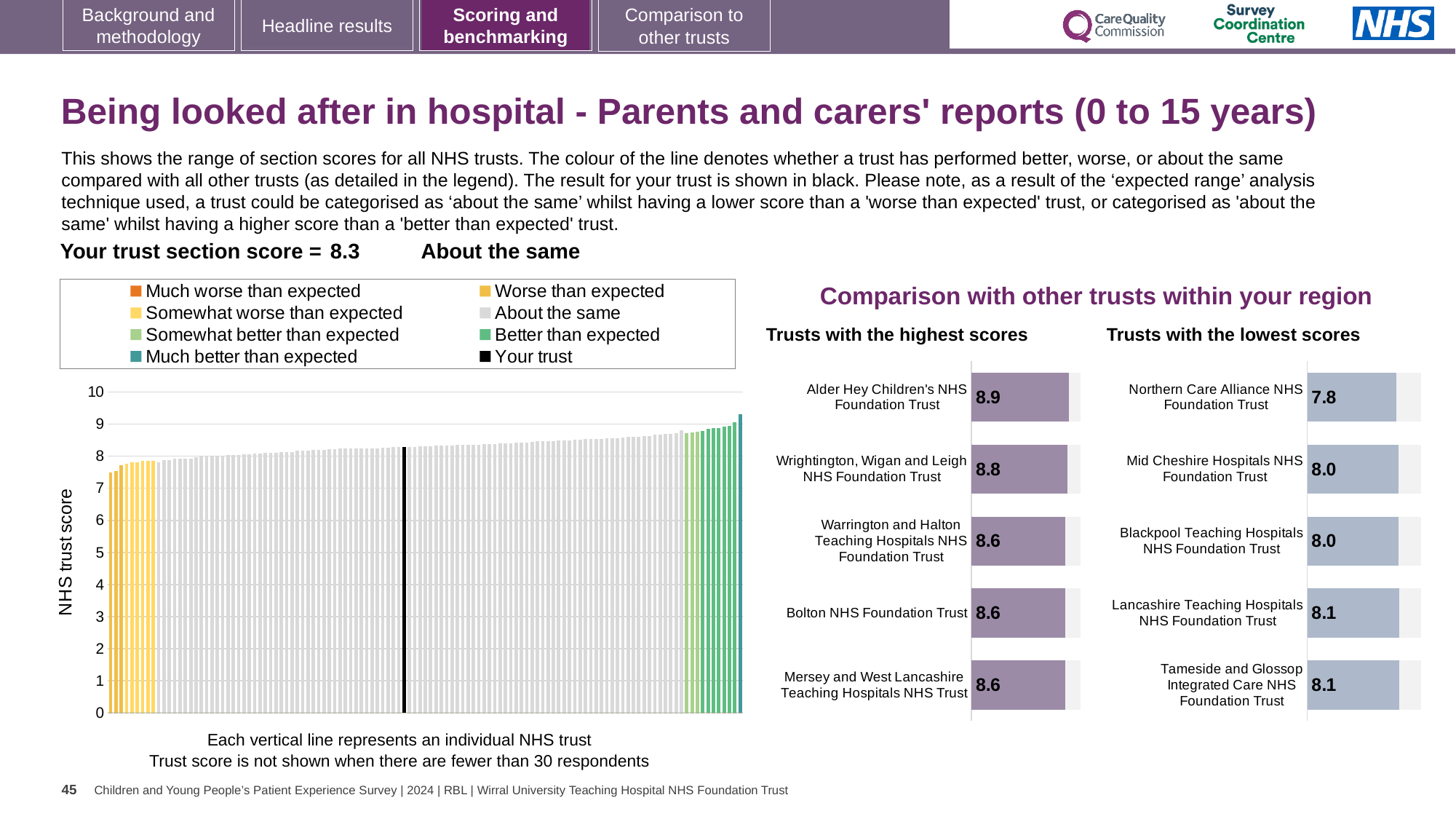
In the NHS trust score chart on the left, do the values rise or fall from left to right along the x axis? Rise In the 'Trusts with the lowest scores' chart, what is the score for Lancashire Teaching Hospitals NHS Foundation Trust? 8.1 In the 'Trusts with the highest scores' chart, what is the score for Alder Hey Children's NHS Foundation Trust? 8.9 How many entries does the legend of the NHS trust score chart on the left list? 8 What kind of chart is the NHS trust score chart on the left of the slide? Bar chart What is the difference between the score for Alder Hey Children's NHS Foundation Trust in the 'Trusts with the highest scores' chart and the score for Northern Care Alliance NHS Foundation Trust in the 'Trusts with the lowest scores' chart? 1.1 In the 'Trusts with the lowest scores' chart, which trust has the lowest score? Northern Care Alliance NHS Foundation Trust In the 'Trusts with the highest scores' chart, which has the larger score: Alder Hey Children's NHS Foundation Trust or Wrightington, Wigan and Leigh NHS Foundation Trust? Alder Hey Children's NHS Foundation Trust In the 'Trusts with the highest scores' chart, which trust has the highest score? Alder Hey Children's NHS Foundation Trust In the NHS trust score chart on the left, is the value of the leftmost bar greater or less than 8? less How many trusts are shown in the 'Trusts with the lowest scores' chart? 5 In the 'Trusts with the lowest scores' chart, what is the score for Northern Care Alliance NHS Foundation Trust? 7.8